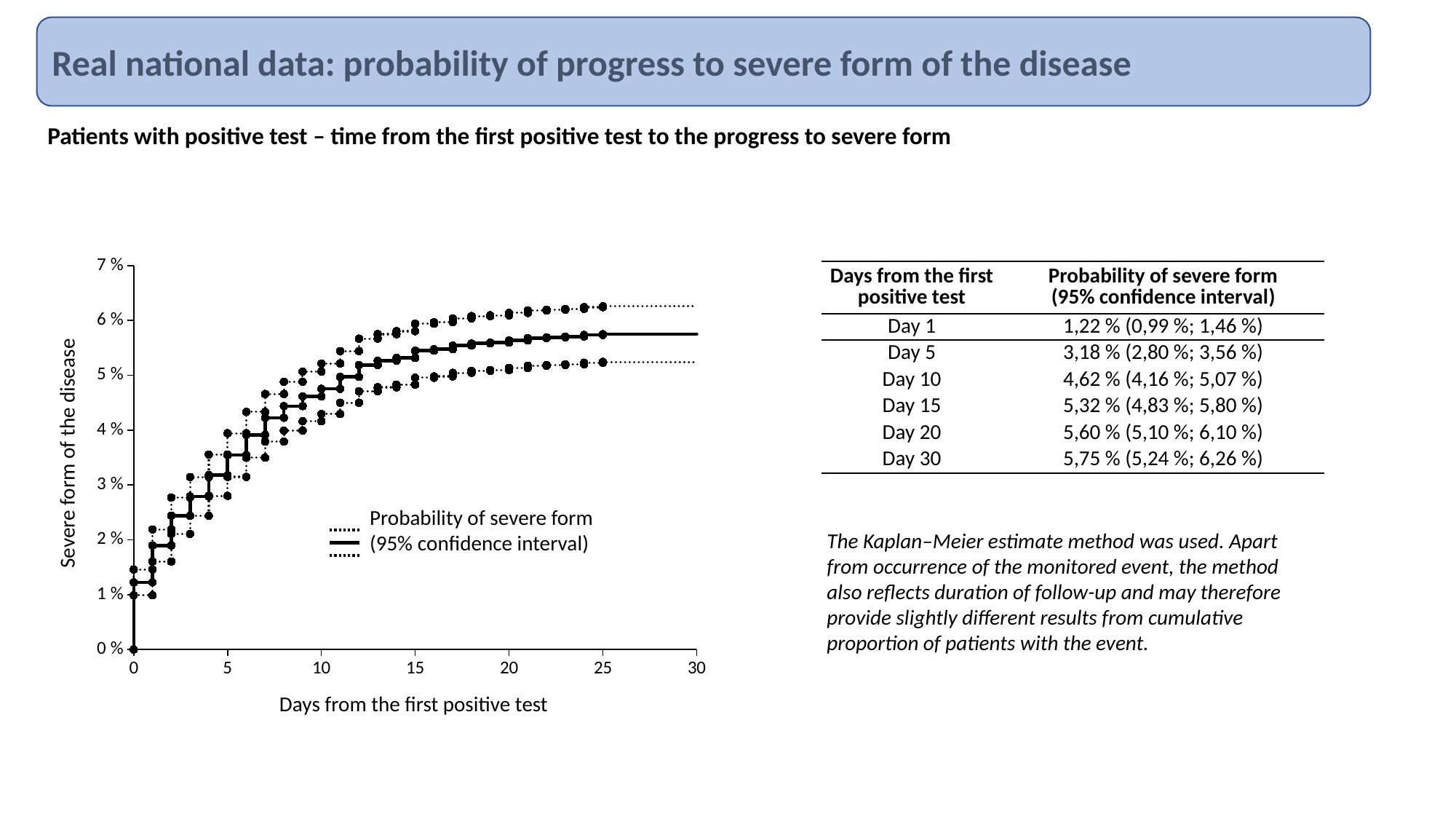
What is the difference between the probability of severe form at Day 30 and at Day 1? 4,53 % Is the probability of severe form (solid line) at day 25 greater or less than 5 %? greater What kind of chart is shown on the slide? line chart Does the probability of severe form rise or fall as days from the first positive test increase? rise Is the probability of severe form at day 1 greater or less than 2 %? less According to the table, what is the probability of severe form at Day 30? 5,75 % How many days are listed in the table of probabilities? 6 According to the table, what is the probability of severe form at Day 5? 3,18 % What is the label of the x axis of the chart? Days from the first positive test Which has the higher probability of severe form, Day 10 or Day 15? Day 15 What is the upper bound of the 95% confidence interval at Day 30? 6,26 % What is the difference between the probability of severe form at Day 20 and at Day 10? 0,98 %